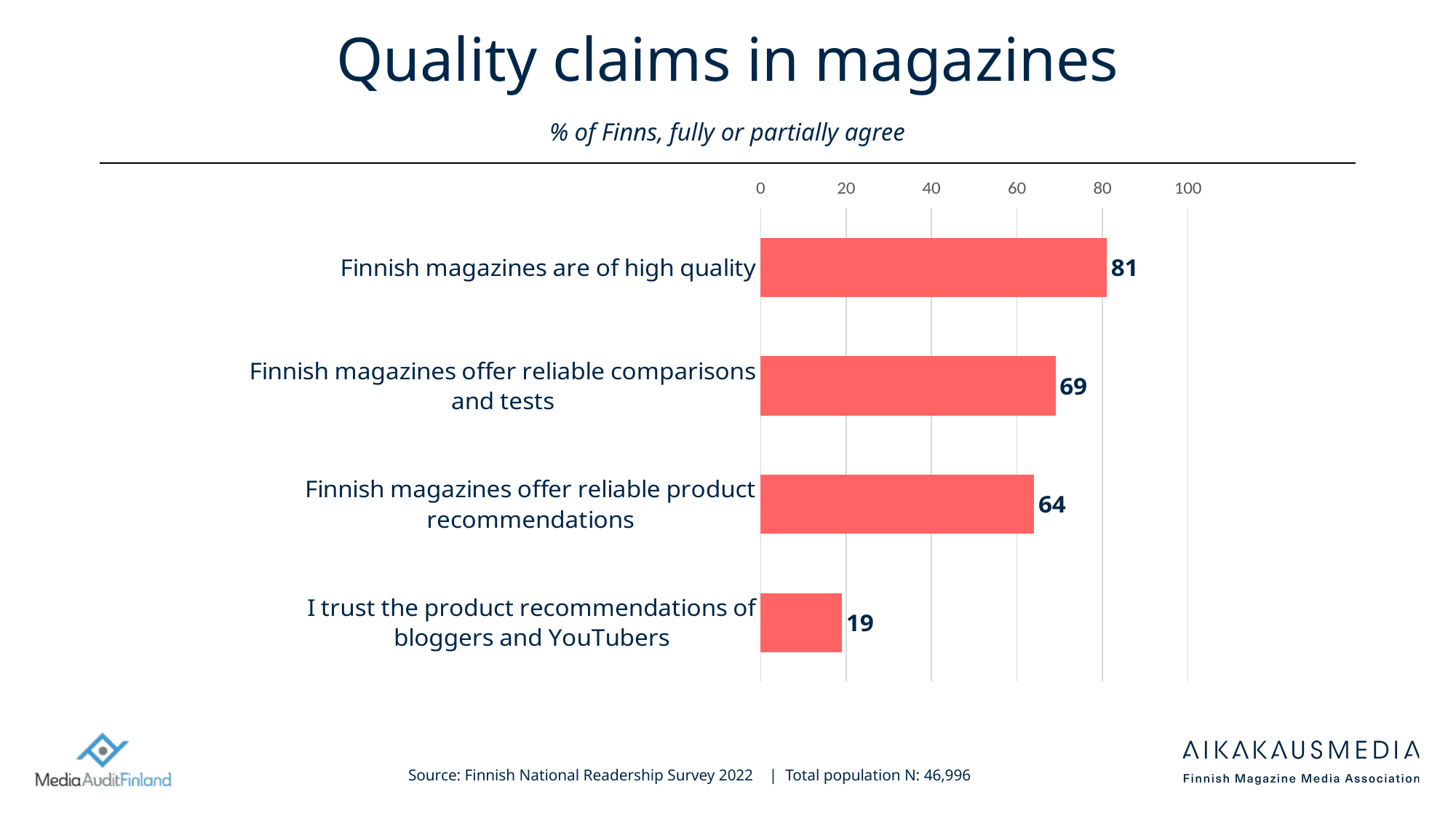
What percentage of Finns agree that Finnish magazines are of high quality? 81 What is the value for 'I trust the product recommendations of bloggers and YouTubers'? 19 What is the difference between the values for 'Finnish magazines are of high quality' and 'Finnish magazines offer reliable product recommendations'? 17 What is the maximum value shown on the horizontal axis? 100 What is the title of the chart? Quality claims in magazines Which statement has the lowest share of agreement? I trust the product recommendations of bloggers and YouTubers Which statement has the highest share of agreement? Finnish magazines are of high quality Which is larger: the value for 'Finnish magazines offer reliable comparisons and tests' or for 'Finnish magazines offer reliable product recommendations'? Finnish magazines offer reliable comparisons and tests How many statements are shown in the chart? 4 Is the value for 'Finnish magazines offer reliable product recommendations' greater or less than 60? greater What is the value for 'Finnish magazines offer reliable comparisons and tests'? 69 What kind of chart is shown on the slide? Bar chart